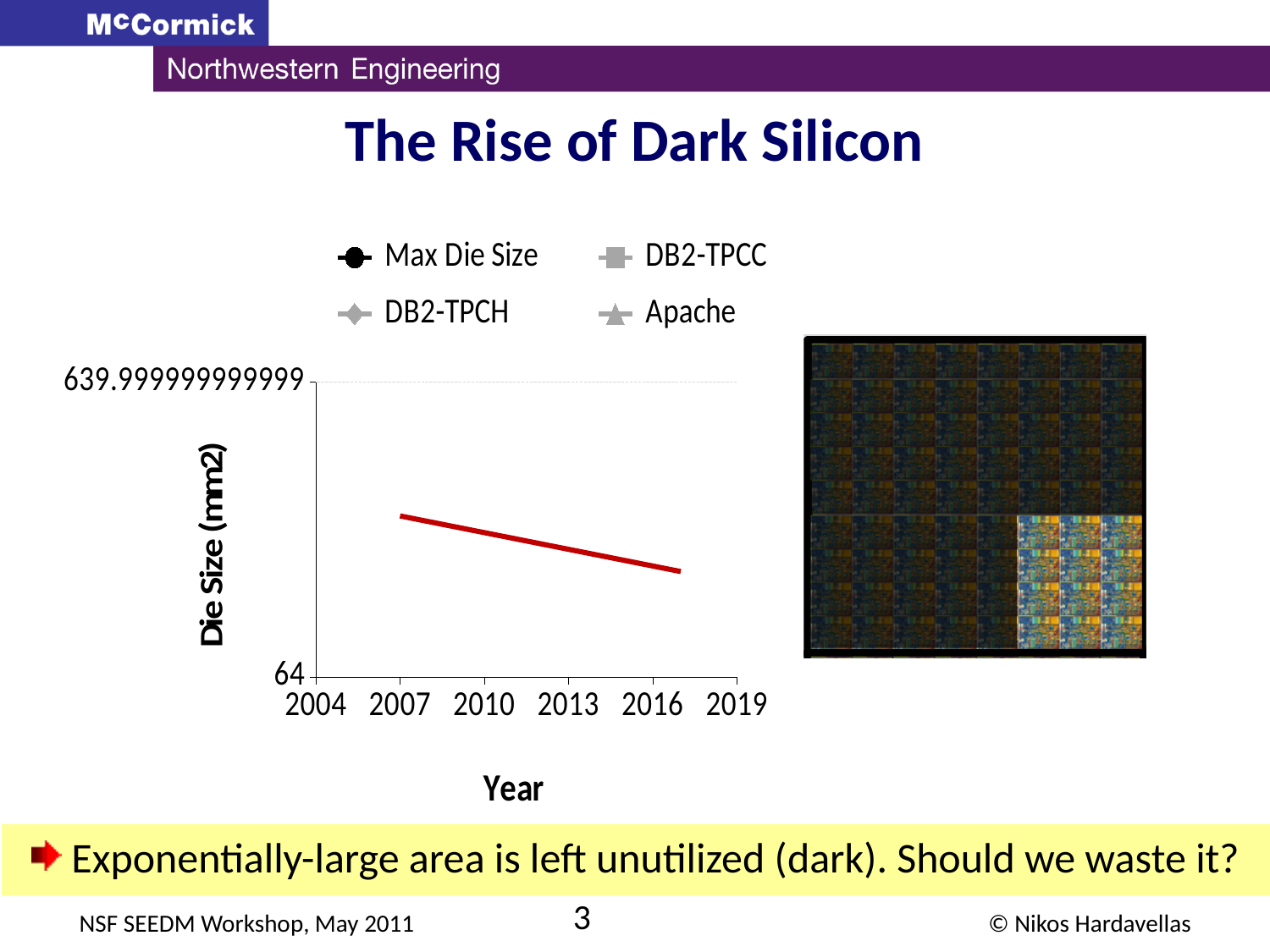
What is the lowest value labelled on the y axis of the chart? 64 What is the first year labelled on the x axis of the chart? 2004 What is the last year labelled on the x axis of the chart? 2019 What is the title of the chart's x axis? Year What kind of chart is shown on the slide? line chart How many series does the chart legend list? 4 What is the title of the chart's y axis? Die Size (mm2) How many year labels are shown along the x axis of the chart? 6 Does the plotted red line rise or fall as the year increases along the x axis? fall